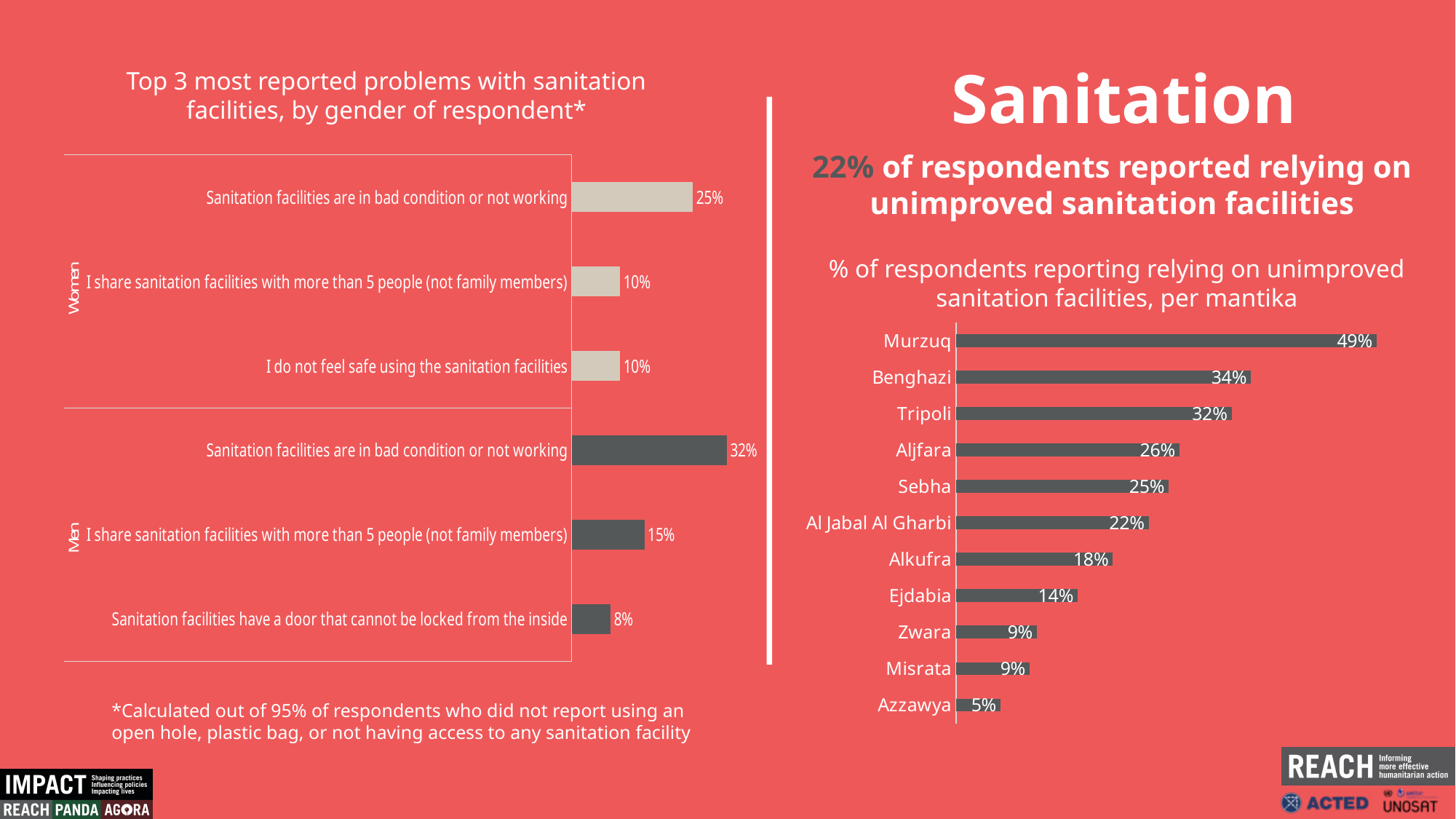
In the chart '% of respondents reporting relying on unimproved sanitation facilities, per mantika', what is the value for Murzuq? 49% What kind of chart is the '% of respondents reporting relying on unimproved sanitation facilities, per mantika' chart? Bar chart In the chart '% of respondents reporting relying on unimproved sanitation facilities, per mantika', what is the difference between Benghazi and Tripoli? 2% In the chart 'Top 3 most reported problems with sanitation facilities, by gender of respondent', what percentage of men reported sharing sanitation facilities with more than 5 people (not family members)? 15% In the chart '% of respondents reporting relying on unimproved sanitation facilities, per mantika', how many mantikas are shown? 11 In the chart '% of respondents reporting relying on unimproved sanitation facilities, per mantika', which is larger, Sebha or Alkufra? Sebha In the chart 'Top 3 most reported problems with sanitation facilities, by gender of respondent', which problem has the lowest value among men? Sanitation facilities have a door that cannot be locked from the inside In the chart '% of respondents reporting relying on unimproved sanitation facilities, per mantika', which mantika has the lowest value? Azzawya In the chart '% of respondents reporting relying on unimproved sanitation facilities, per mantika', what is the value for Ejdabia? 14% In the chart 'Top 3 most reported problems with sanitation facilities, by gender of respondent', what percentage of women reported that sanitation facilities are in bad condition or not working? 25% In the chart 'Top 3 most reported problems with sanitation facilities, by gender of respondent', what is the difference between men and women reporting that sanitation facilities are in bad condition or not working? 7%